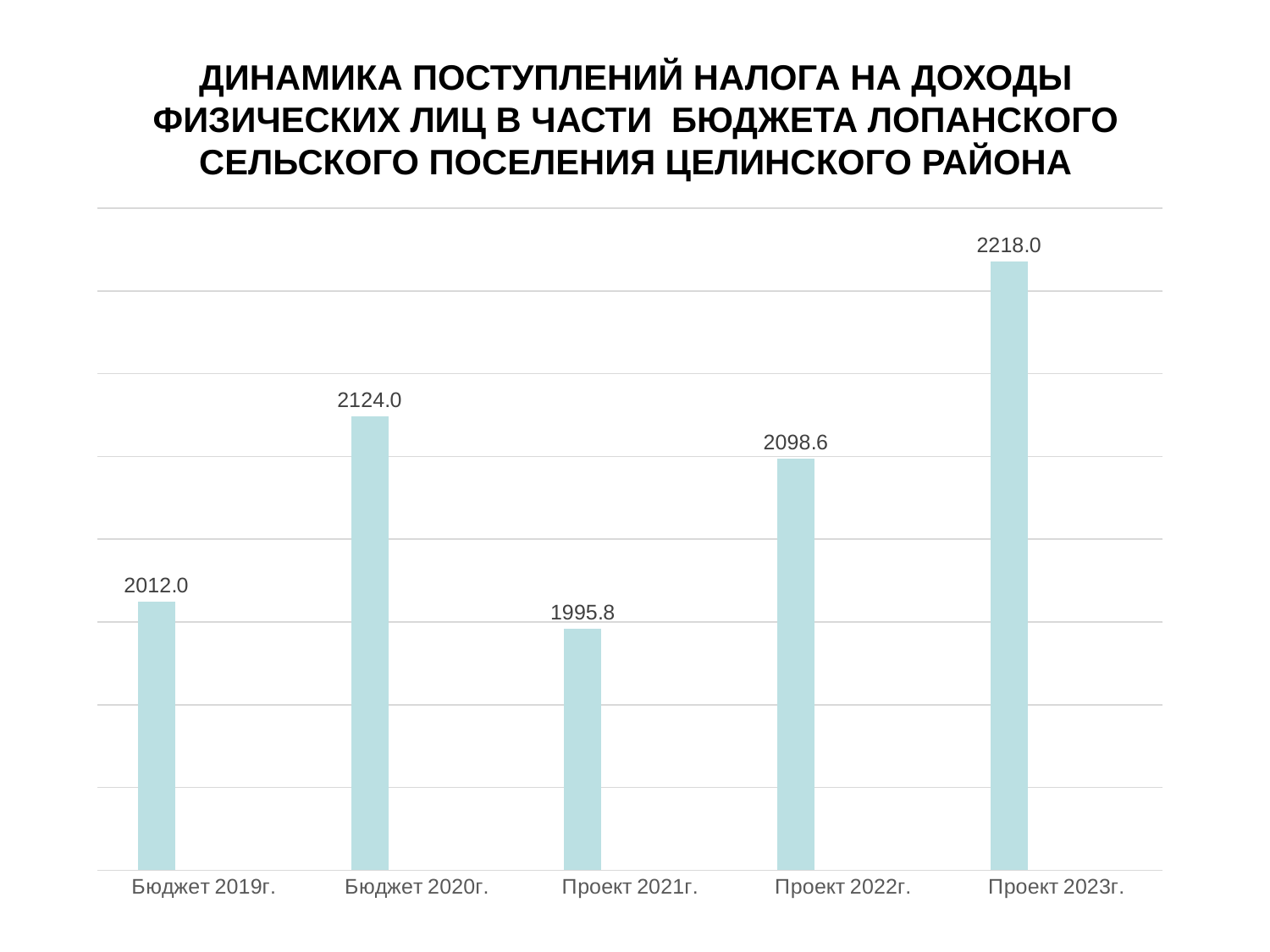
What is the difference between the values for Бюджет 2020г. and Проект 2022г.? 25.4 Which category has the lowest value? Проект 2021г. Which is larger, the value for Бюджет 2020г. or the value for Проект 2021г.? Бюджет 2020г. What is the value for Проект 2023г.? 2218.0 Which category has the highest value? Проект 2023г. What is the value for Бюджет 2019г.? 2012.0 What kind of chart is shown on the slide? Bar chart What is the difference between the values for Проект 2023г. and Бюджет 2019г.? 206.0 What is the value for Бюджет 2020г.? 2124.0 How many categories are shown on the chart? 5 What is the value for Проект 2021г.? 1995.8 What is the value for Проект 2022г.? 2098.6